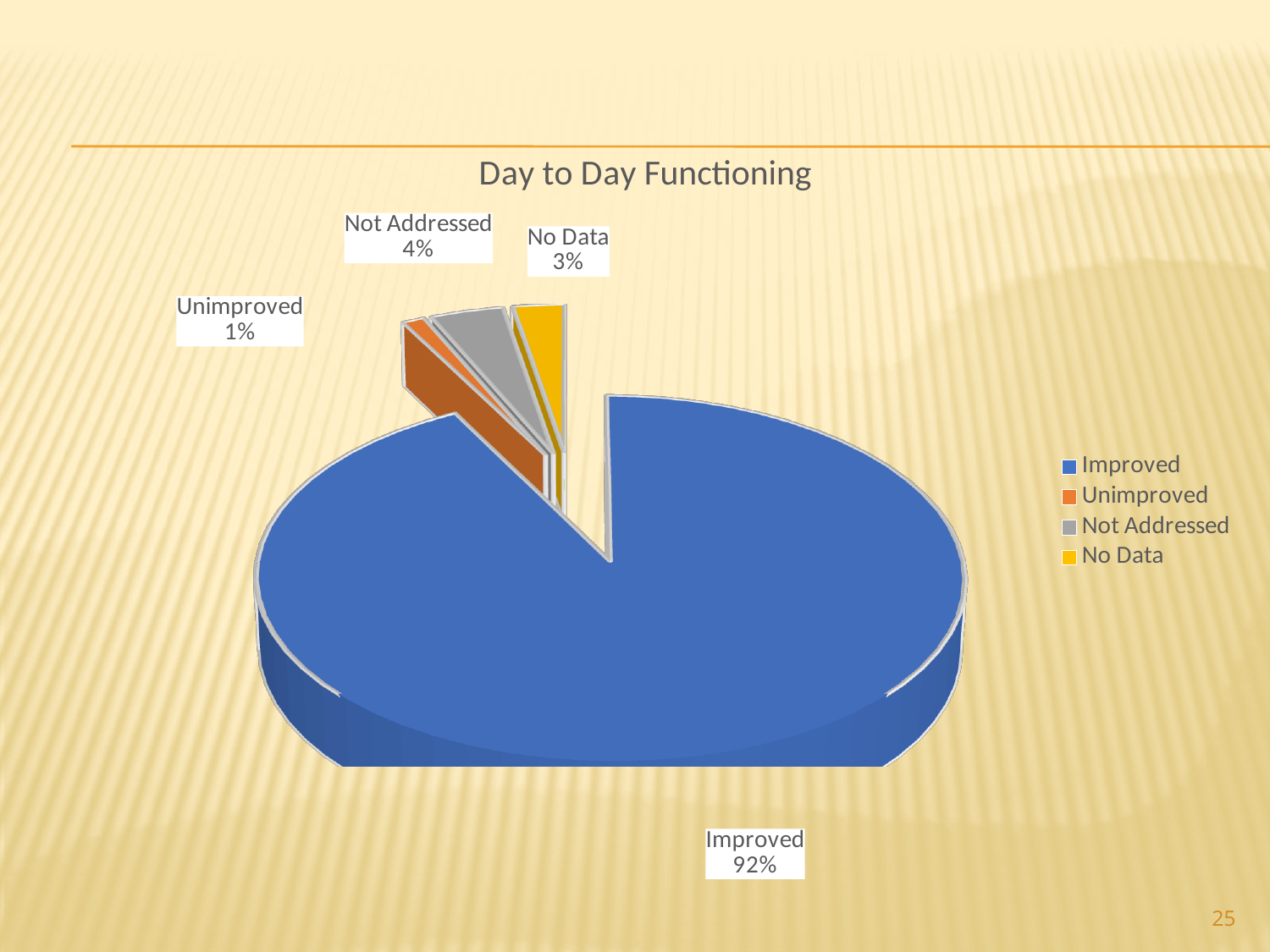
What is the title of the chart? Day to Day Functioning What percentage of the pie is labelled Improved? 92% What percentage of the pie is labelled Not Addressed? 4% How many categories does the legend list? 4 Which category has the smallest share of the pie? Unimproved Which slice is larger, Not Addressed or Unimproved? Not Addressed What colour is the Improved slice? blue What percentage of the pie is labelled Unimproved? 1% Which category has the largest share of the pie? Improved What is the difference in percentage points between the Not Addressed and No Data slices? 1% What kind of chart is shown on the slide? pie chart What percentage of the pie is labelled No Data? 3%